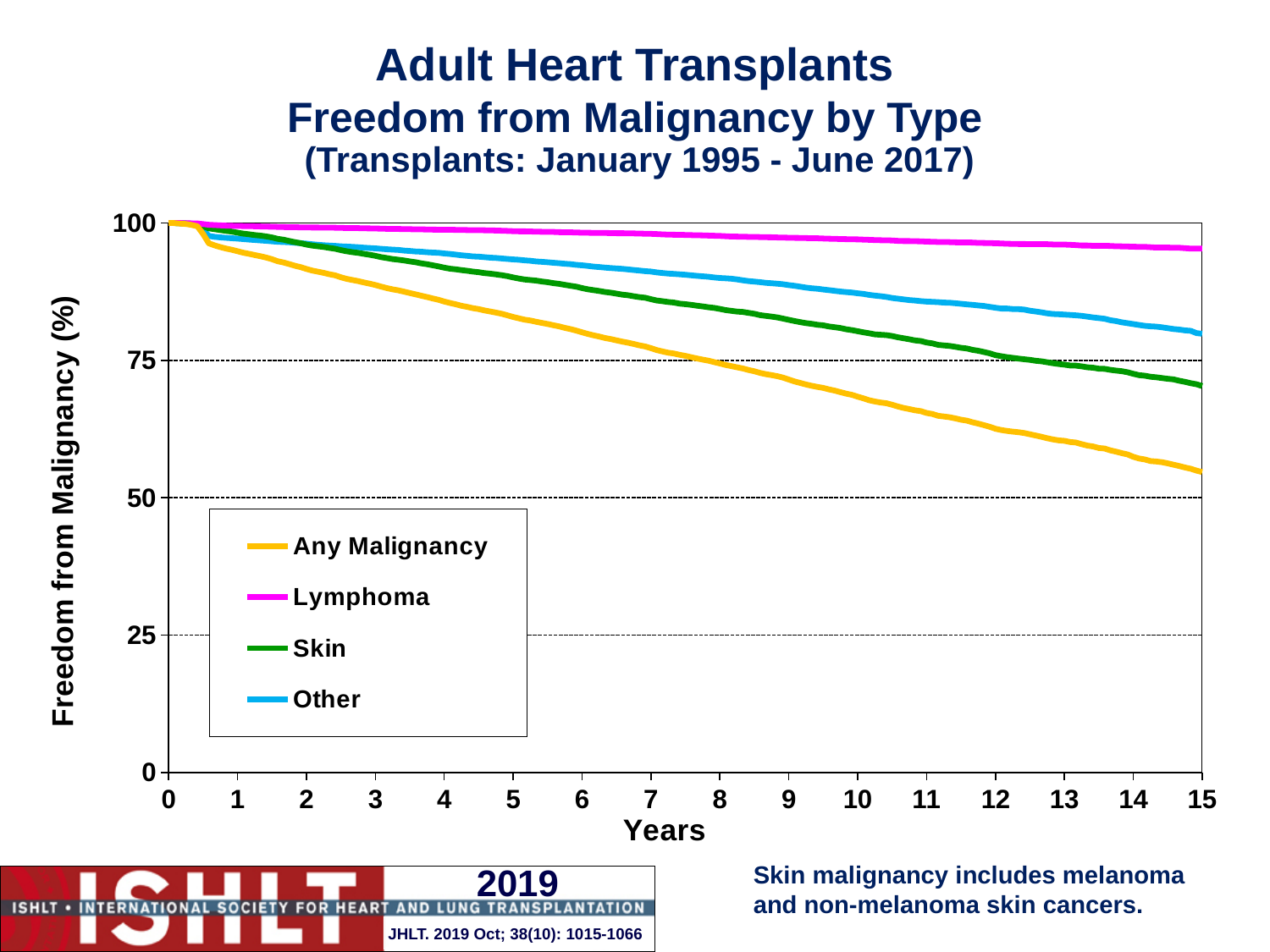
What kind of chart is shown on the slide? Line chart Which series has the highest freedom from malignancy at 15 years? Lymphoma Is the value for Any Malignancy at 15 years greater or less than 50? greater Is the value for Skin at 15 years greater or less than 75? less Which series has the lowest freedom from malignancy at 15 years? Any Malignancy Do the values for Any Malignancy rise or fall as years increase? Fall Is the value for Any Malignancy at 10 years greater or less than 75? less How many series does the legend list? 4 At 10 years, which is higher: Other or Any Malignancy? Other What colour is the line for Lymphoma? Magenta (pink) What is the label of the y axis? Freedom from Malignancy (%)